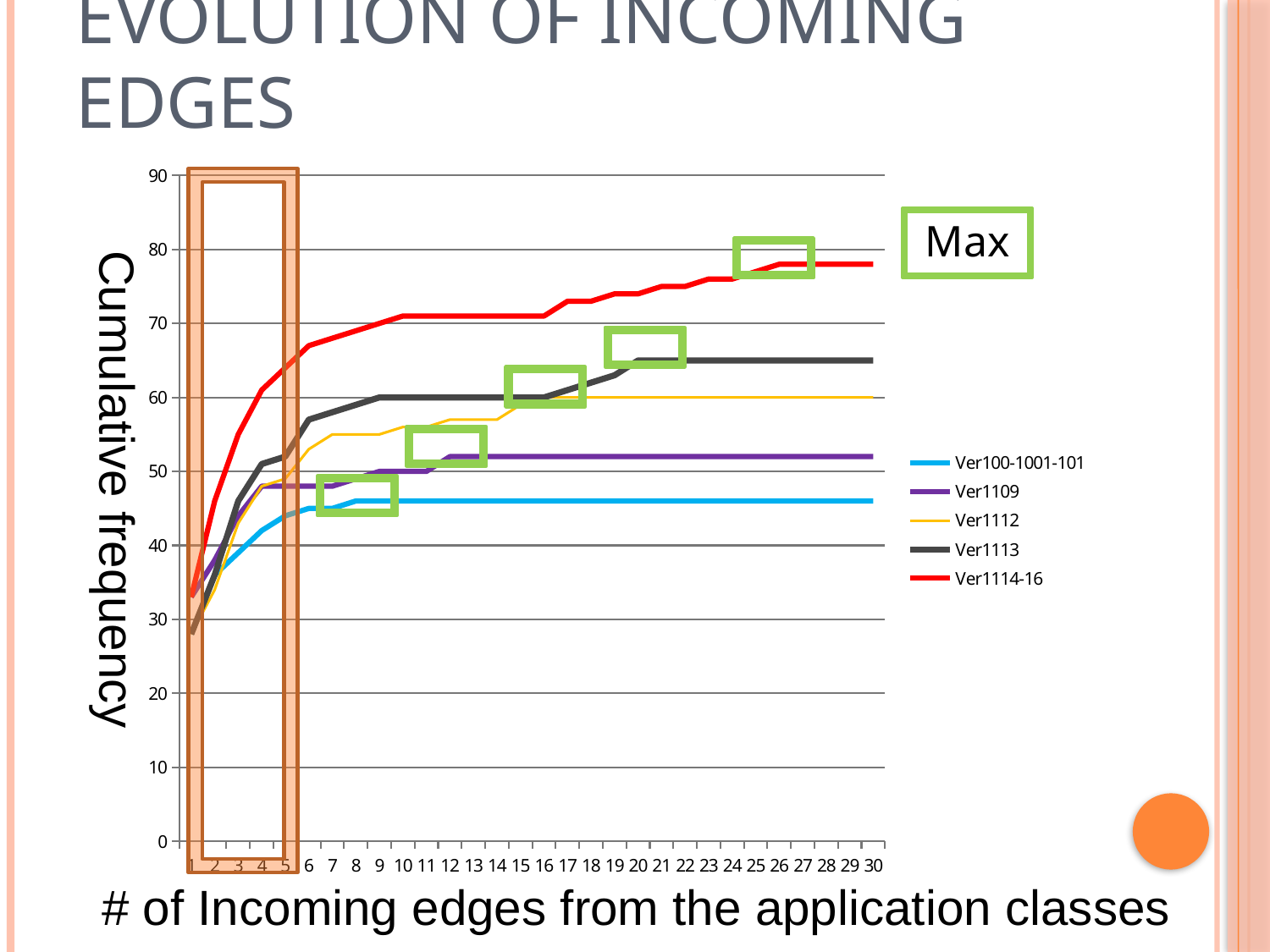
Is the value for Ver100-1001-101 at x = 30 greater or less than 50? less What kind of chart is shown on the slide? line chart Is the value for Ver1113 at x = 30 greater or less than 60? greater How many series does the legend list? 5 Is the value for Ver1114-16 at x = 30 greater or less than 70? greater Do the values of the Ver1114-16 series rise or fall as x increases? rise Which series has the lowest cumulative frequency at x = 30? Ver100-1001-101 Which series has the highest cumulative frequency at x = 30? Ver1114-16 How many points are on the x axis of the chart? 30 At x = 30, which is larger: the value for Ver1109 or the value for Ver1112? Ver1112 Which series is drawn in red? Ver1114-16 What is the label of the y axis? Cumulative frequency